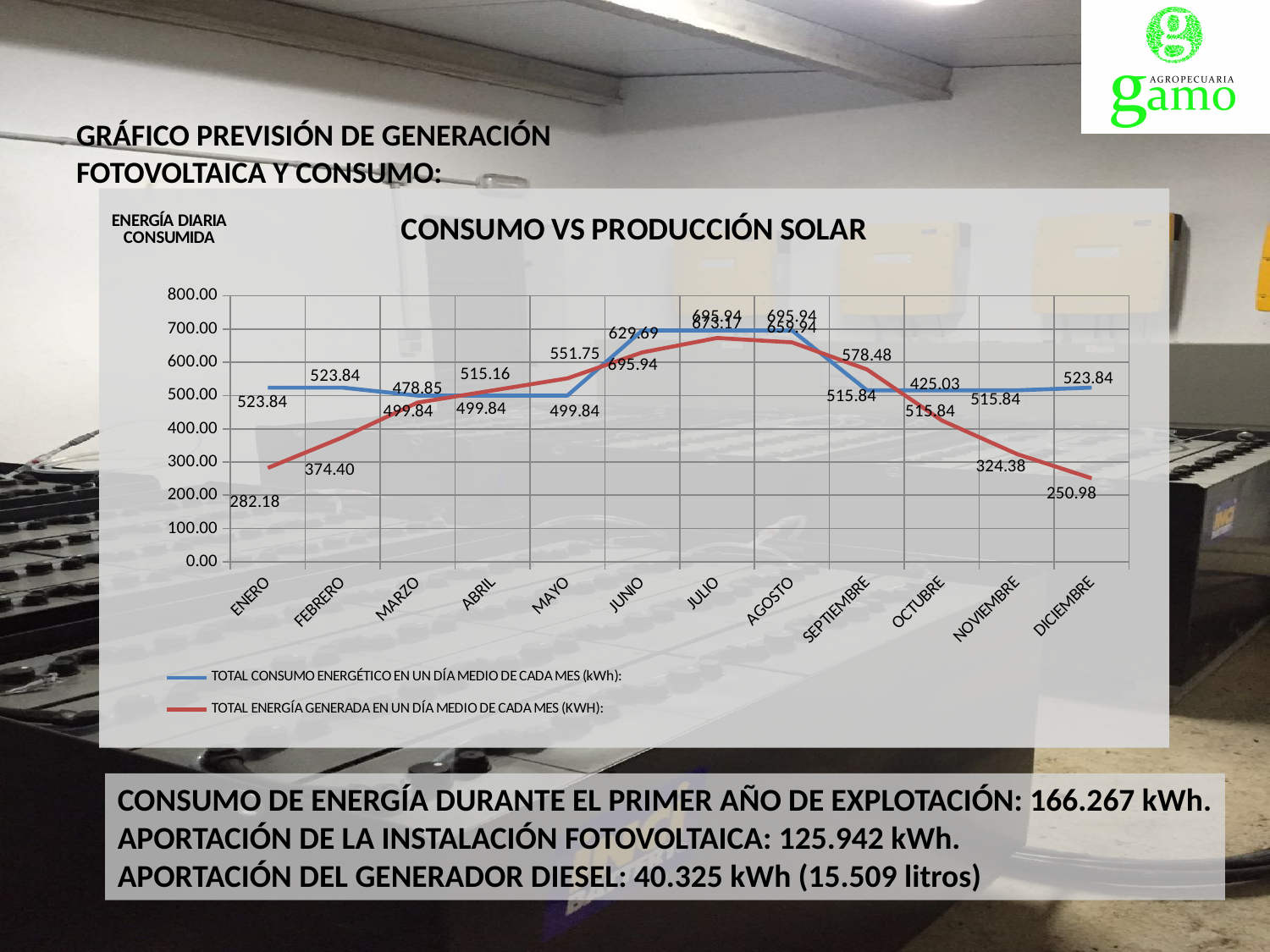
What is the title of the chart? CONSUMO VS PRODUCCIÓN SOLAR Is the value of TOTAL ENERGÍA GENERADA for NOVIEMBRE greater or less than 400? less How many months are plotted along the x axis of the chart? 12 What is the value of TOTAL CONSUMO ENERGÉTICO EN UN DÍA MEDIO DE CADA MES for JUNIO? 695.94 What is the value of TOTAL ENERGÍA GENERADA EN UN DÍA MEDIO DE CADA MES for ENERO? 282.18 What is the value of TOTAL ENERGÍA GENERADA EN UN DÍA MEDIO DE CADA MES for OCTUBRE? 425.03 Does the TOTAL ENERGÍA GENERADA line rise or fall from ENERO to JULIO? rise In MAYO, which is larger: the energy consumed or the energy generated? energy generated What is the difference between the consumption value and the generated energy value for ENERO? 241.66 In which month is TOTAL ENERGÍA GENERADA EN UN DÍA MEDIO DE CADA MES lowest? DICIEMBRE What kind of chart is shown on the slide? line chart How many series does the legend of the chart list? 2